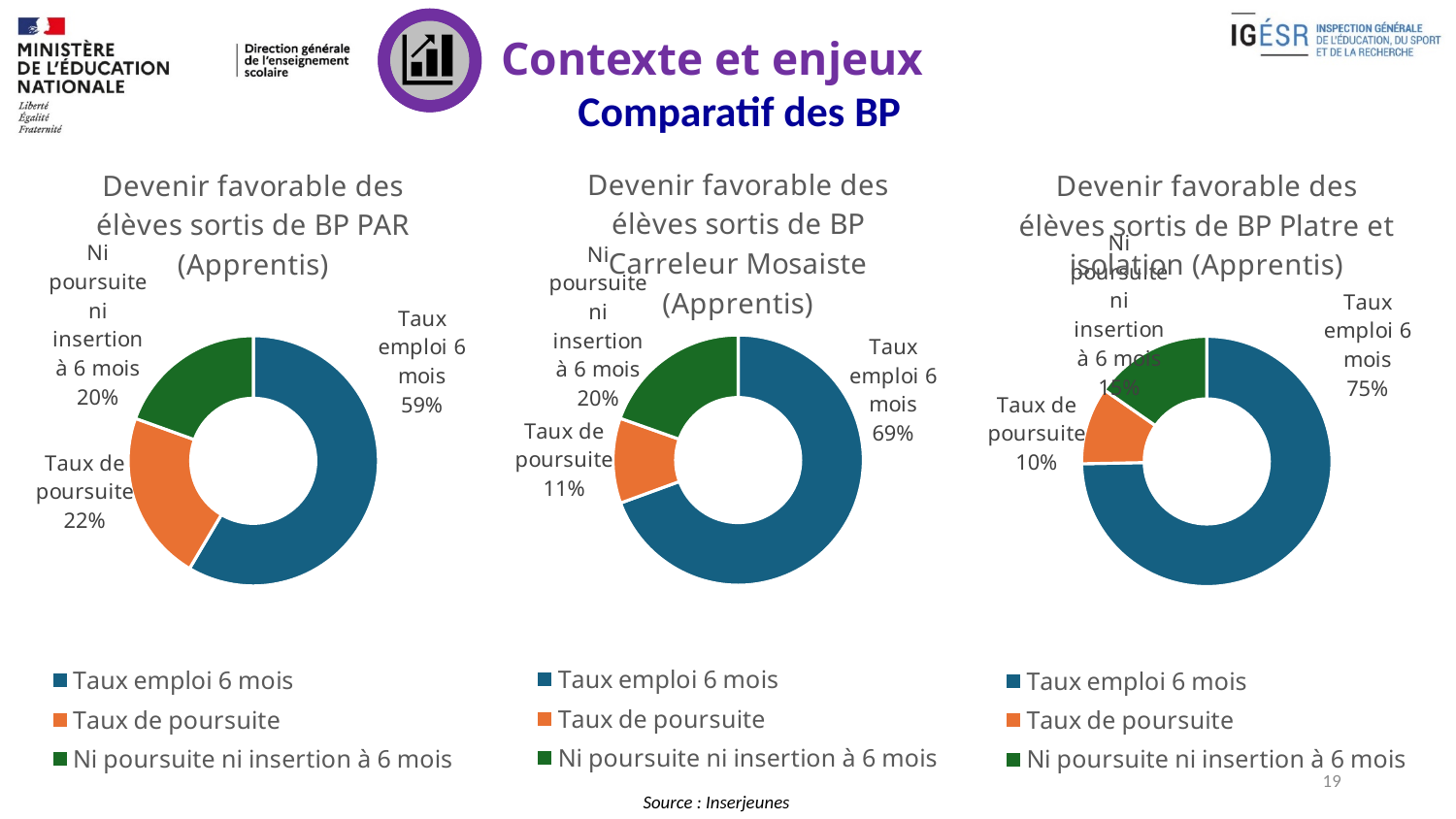
What type of chart is used for the three charts on the slide? Doughnut (pie) chart How many entries does the legend of the left chart list? 3 In the chart titled "Devenir favorable des élèves sortis de BP Platre et isolation (Apprentis)", what is the value for Taux de poursuite? 10% In the chart titled "Devenir favorable des élèves sortis de BP Carreleur Mosaiste (Apprentis)", what is the value for Taux de poursuite? 11% In the chart titled "Devenir favorable des élèves sortis de BP PAR (Apprentis)", which category has the largest share? Taux emploi 6 mois Which is larger: Taux emploi 6 mois in the BP PAR chart (left) or Taux emploi 6 mois in the BP Carreleur Mosaiste chart (middle)? BP Carreleur Mosaiste (69%) In the chart titled "Devenir favorable des élèves sortis de BP PAR (Apprentis)", what is the value for Taux emploi 6 mois? 59% In the chart titled "Devenir favorable des élèves sortis de BP PAR (Apprentis)", what is the difference between Taux emploi 6 mois and Taux de poursuite? 37 percentage points In the chart titled "Devenir favorable des élèves sortis de BP Carreleur Mosaiste (Apprentis)", what is the value for Ni poursuite ni insertion à 6 mois? 20% In the chart titled "Devenir favorable des élèves sortis de BP Platre et isolation (Apprentis)", what is the value for Taux emploi 6 mois? 75% In the chart titled "Devenir favorable des élèves sortis de BP Carreleur Mosaiste (Apprentis)", which category has the smallest share? Taux de poursuite In the chart titled "Devenir favorable des élèves sortis de BP PAR (Apprentis)", what is the value for Taux de poursuite? 22%